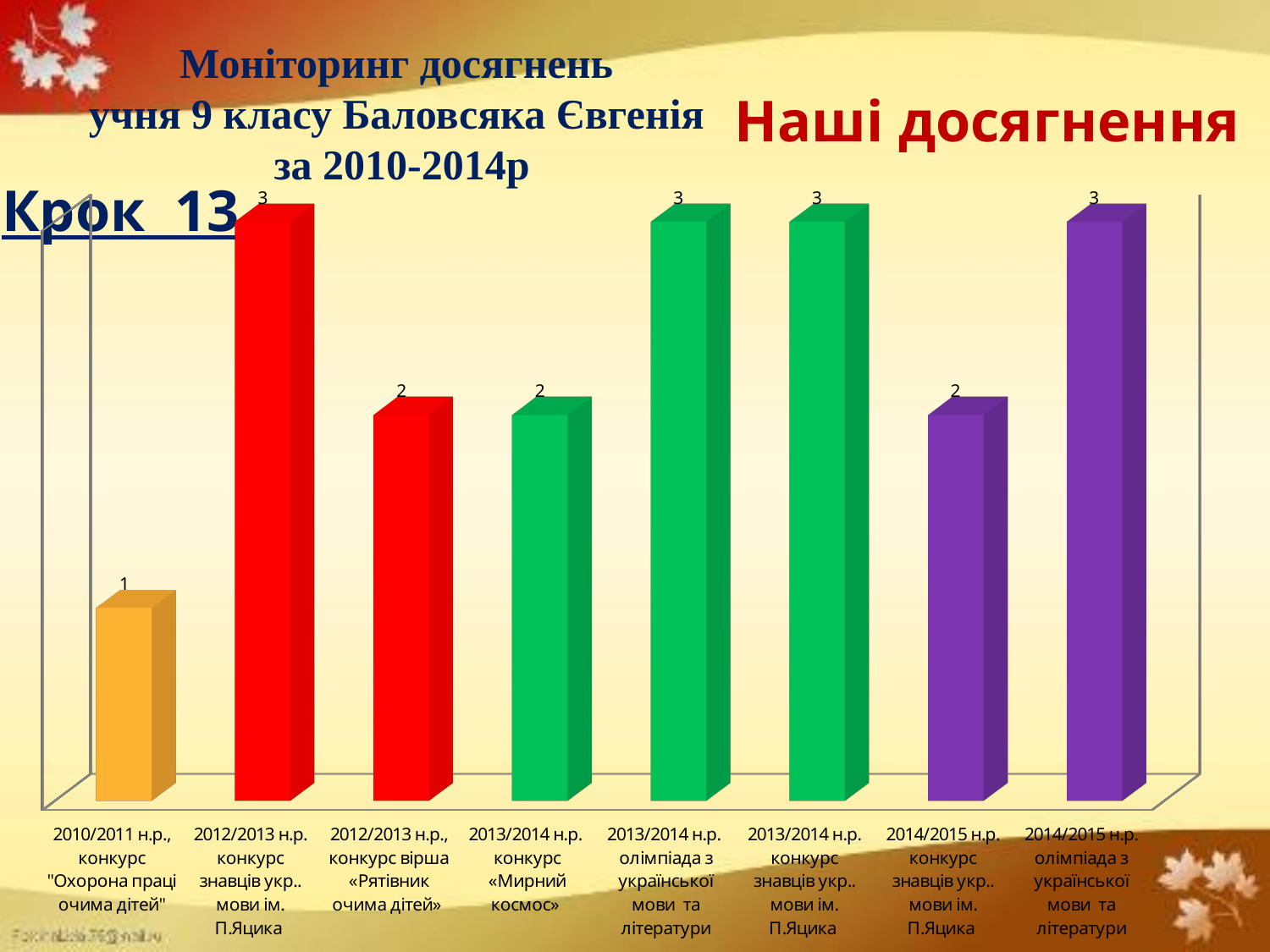
What is the value for the 2013/2014 н.р. конкурс «Мирний космос» bar? 2 What is the difference between the value for 2012/2013 н.р. конкурс знавців укр.. мови ім. П.Яцика and the value for 2010/2011 н.р. конкурс "Охорона праці очима дітей"? 2 Which is larger: the value for 2013/2014 н.р. олімпіада з української мови та літератури or the value for 2014/2015 н.р. конкурс знавців укр.. мови ім. П.Яцика? 2013/2014 н.р. олімпіада з української мови та літератури What is the difference between the value for 2014/2015 н.р. олімпіада з української мови та літератури and the value for 2014/2015 н.р. конкурс знавців укр.. мови ім. П.Яцика? 1 Which category has the lowest value in the chart? 2010/2011 н.р., конкурс "Охорона праці очима дітей" What is the value for the 2010/2011 н.р. конкурс "Охорона праці очима дітей" bar? 1 What colour is the bar for 2010/2011 н.р. конкурс "Охорона праці очима дітей"? orange How many bars (categories) does the chart show? 8 What is the value for the 2012/2013 н.р. конкурс вірша «Рятівник очима дітей» bar? 2 How many bars in the chart have a value of 3? 4 What is the value for the 2014/2015 н.р. олімпіада з української мови та літератури bar? 3 What kind of chart is shown on the slide? bar chart